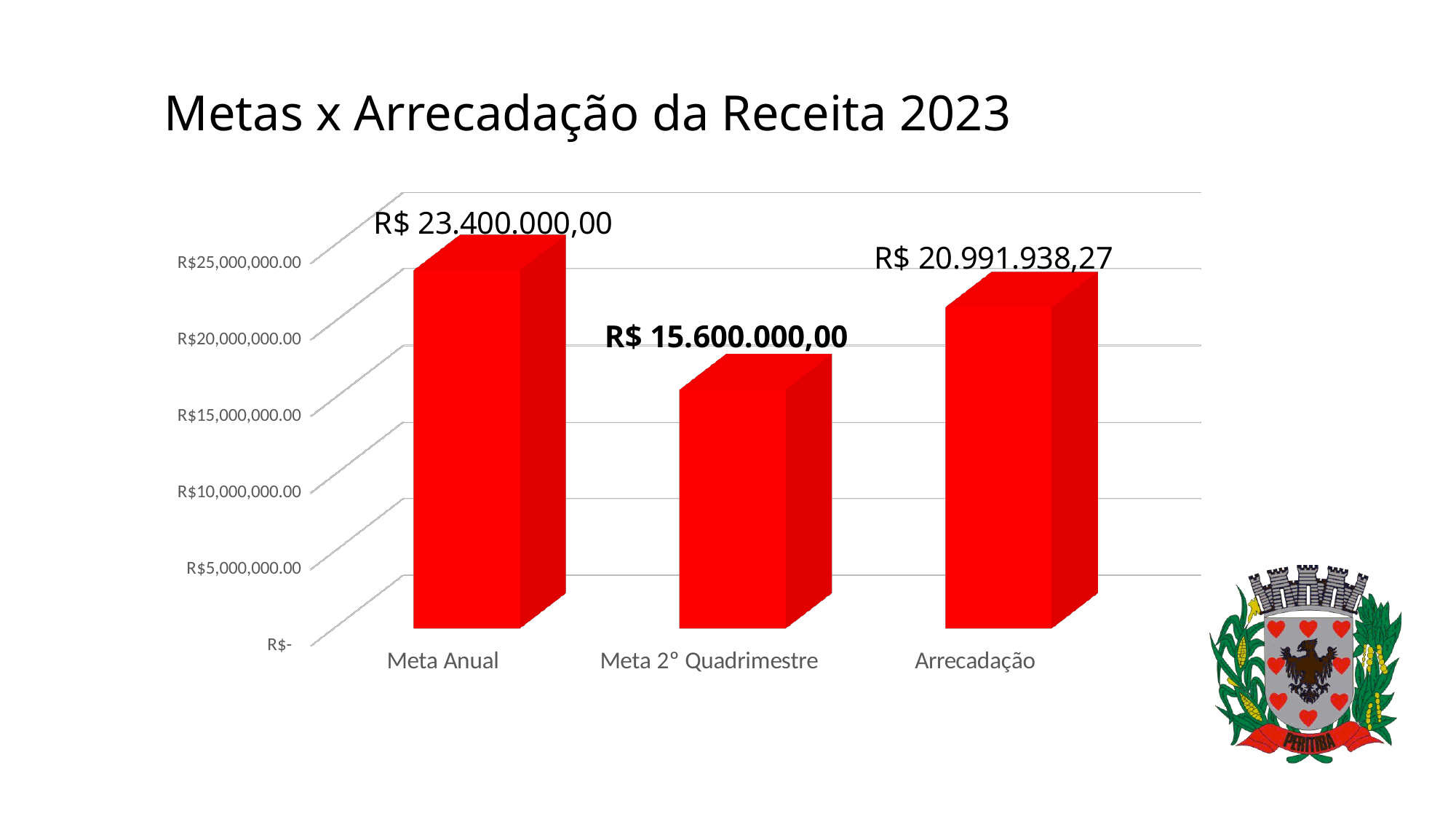
What is the title of the slide? Metas x Arrecadação da Receita 2023 Which is larger, Arrecadação or Meta 2° Quadrimestre? Arrecadação How many categories are shown in the chart? 3 What is the difference between Meta Anual and Arrecadação? R$ 2.408.061,73 What is the value for Meta 2° Quadrimestre? R$ 15.600.000,00 What is the value for Arrecadação? R$ 20.991.938,27 What is the value for Meta Anual? R$ 23.400.000,00 What kind of chart is shown on the slide? bar chart What is the difference between Meta Anual and Meta 2° Quadrimestre? R$ 7.800.000,00 Which category has the lowest value? Meta 2° Quadrimestre Is the value for Arrecadação greater or less than R$20,000,000.00? greater Which category has the highest value? Meta Anual